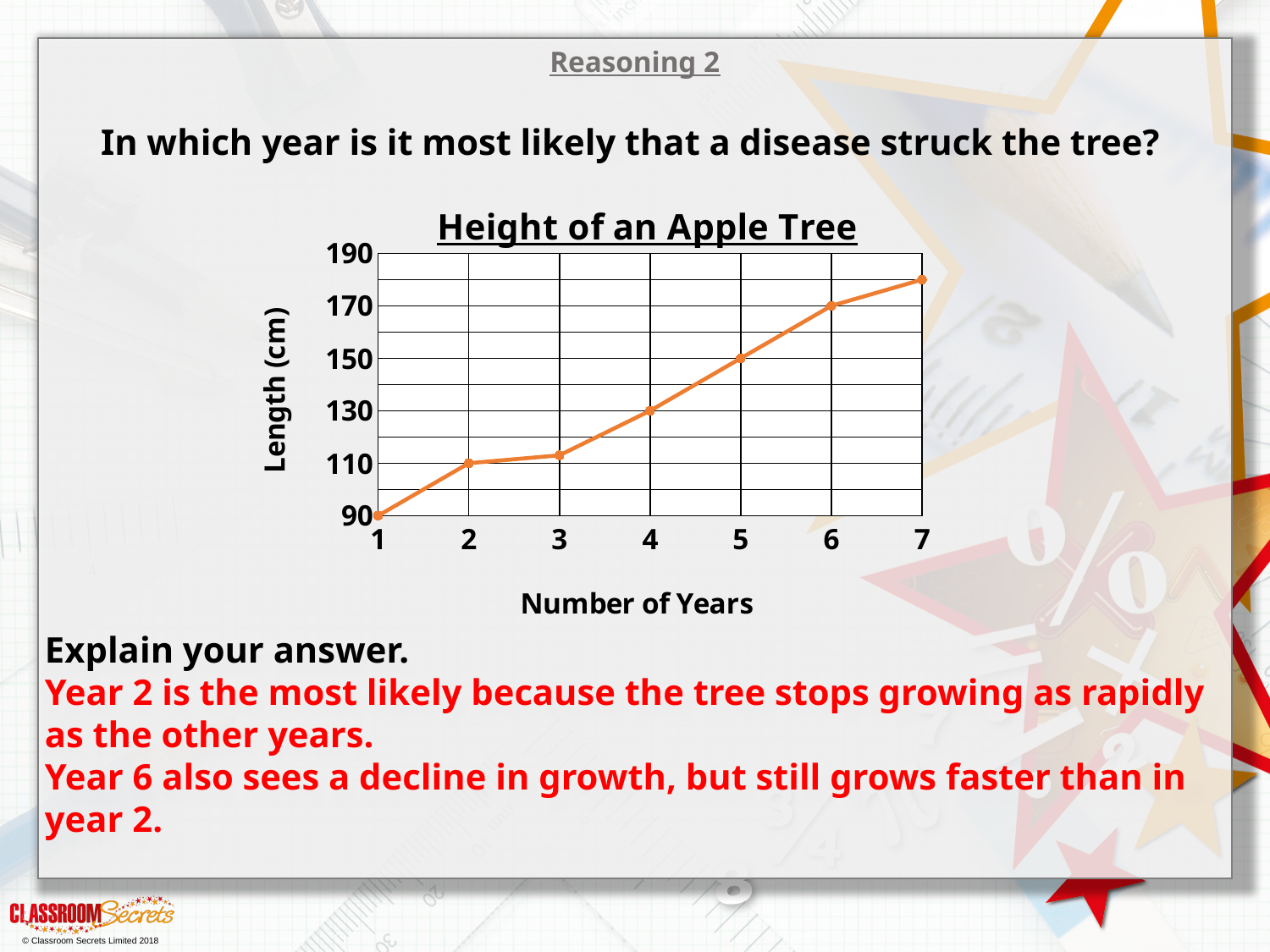
What is the height of the apple tree at year 6? 170 What is the height of the apple tree at year 1? 90 What is the height of the apple tree at year 2? 110 How many years are plotted on the x axis? 7 Does the height of the apple tree rise or fall as the number of years increases? rise In which year is the height of the apple tree lowest? 1 What kind of chart is shown on the slide? line chart What is the difference in height between year 6 and year 2? 60 Which is larger, the height at year 4 or the height at year 2? year 4 Is the height at year 7 greater or less than 170? greater What is the height of the apple tree at year 5? 150 In which year is the height of the apple tree highest? 7